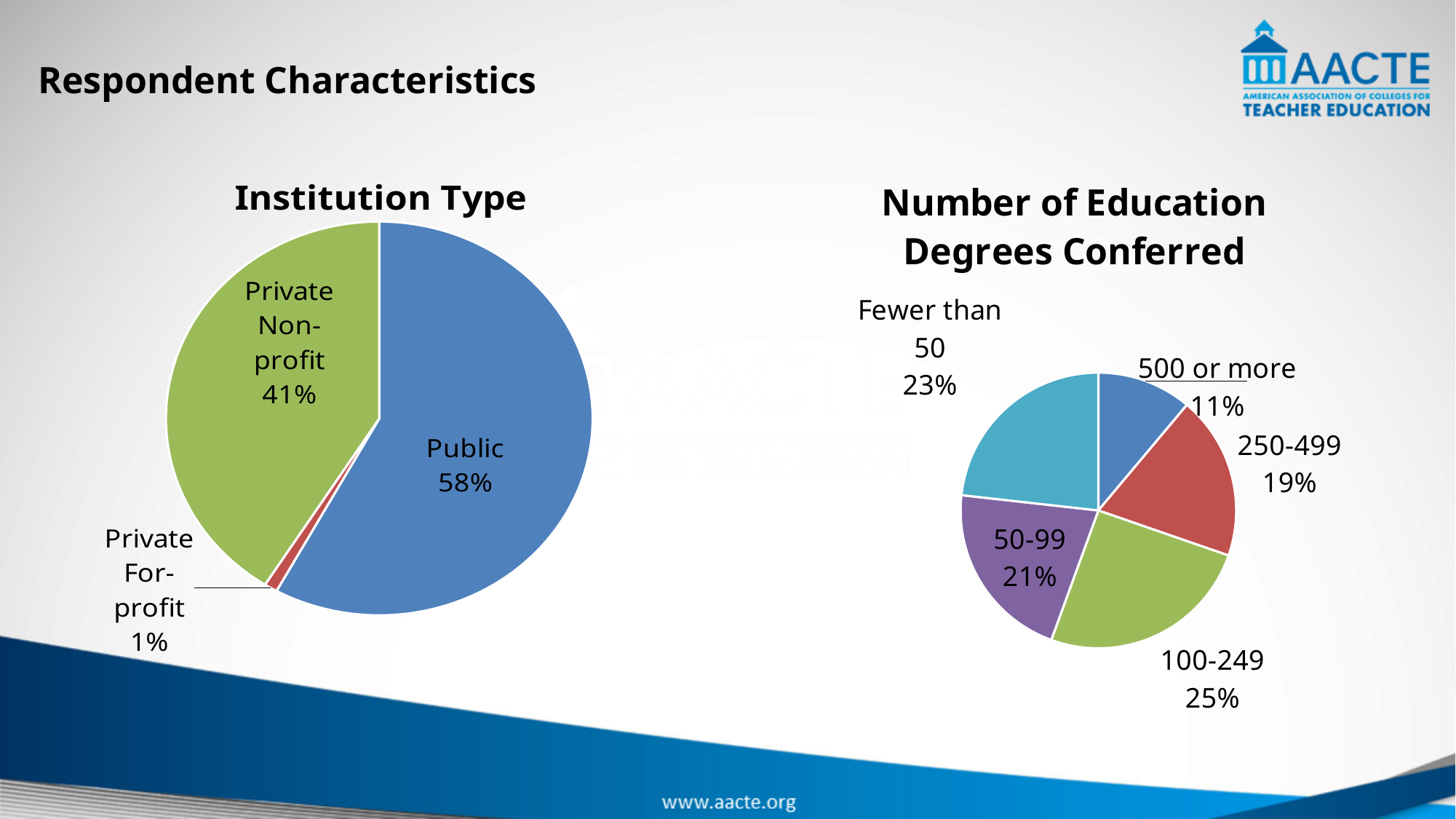
In the Number of Education Degrees Conferred chart, what share of respondents confer 500 or more degrees? 11% In the Number of Education Degrees Conferred chart, which is larger: Fewer than 50 or 250-499? Fewer than 50 In the Number of Education Degrees Conferred chart, which category has the largest share? 100-249 In the Number of Education Degrees Conferred chart, what is the difference in percentage points between 50-99 and 500 or more? 10 In the Institution Type chart, what share of respondents are Public institutions? 58% How many categories does the Number of Education Degrees Conferred chart show? 5 In the Institution Type chart, what share of respondents are Private Non-profit institutions? 41% How many categories does the Institution Type chart show? 3 In the Institution Type chart, what is the difference in percentage points between Public and Private Non-profit? 17 In the Number of Education Degrees Conferred chart, what share of respondents confer 100-249 degrees? 25% In the Institution Type chart, which institution type has the smallest share? Private For-profit What kind of chart is the Number of Education Degrees Conferred chart? Pie chart